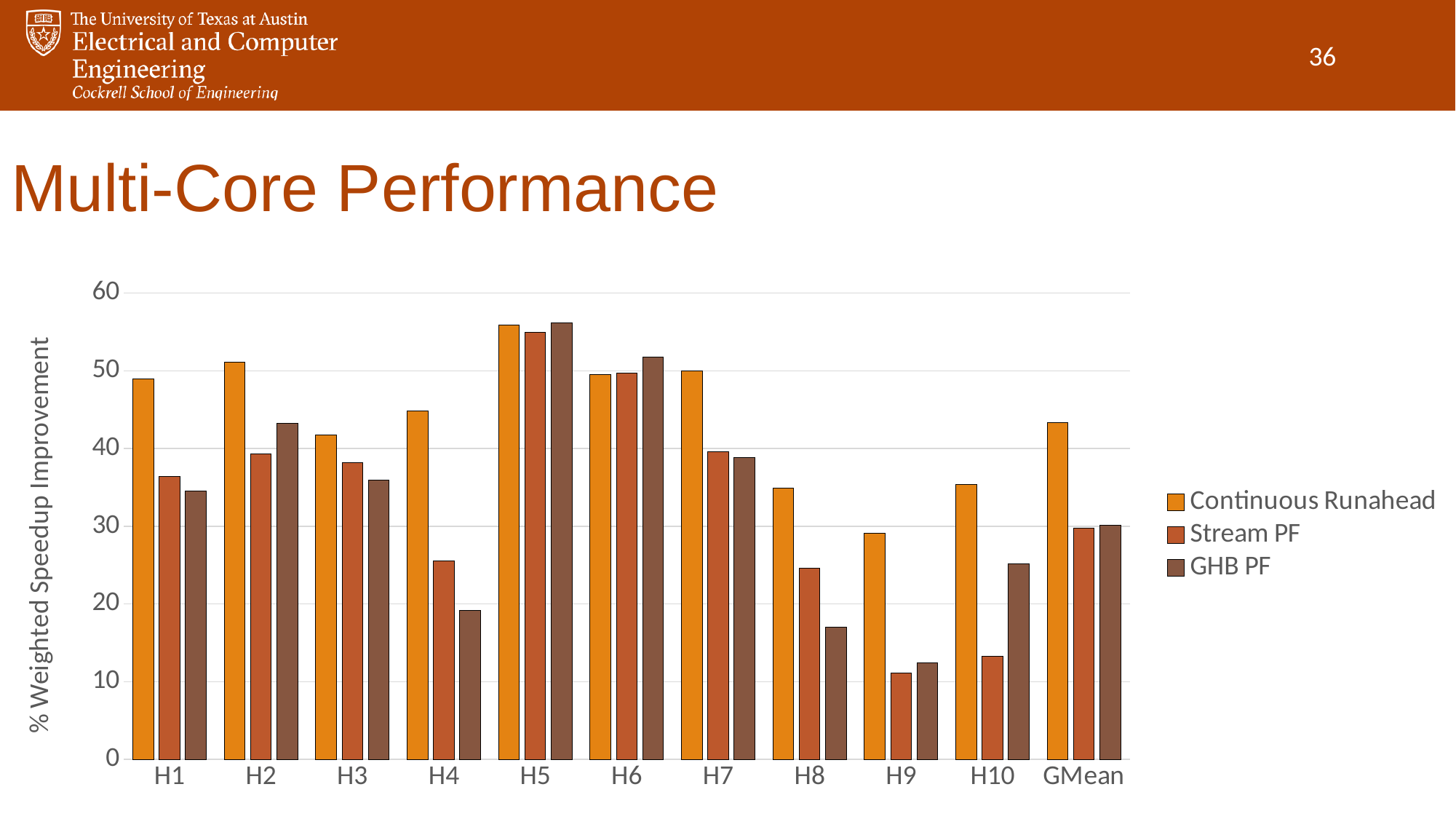
For which category is the Stream PF value lowest? H9 What kind of chart is shown on the slide? bar chart For which category is the Continuous Runahead value lowest? H9 Is the GHB PF value for H2 greater or less than 40? greater How many categories are shown on the x axis? 11 Is the Stream PF value for H4 greater or less than 30? less Is the Continuous Runahead value for H1 greater or less than 40? greater Which series is shown in the lightest orange colour? Continuous Runahead For which category is the Continuous Runahead value highest? H5 For H10, which is larger: the Stream PF value or the GHB PF value? GHB PF What is the label of the y axis? % Weighted Speedup Improvement How many series does the legend list? 3